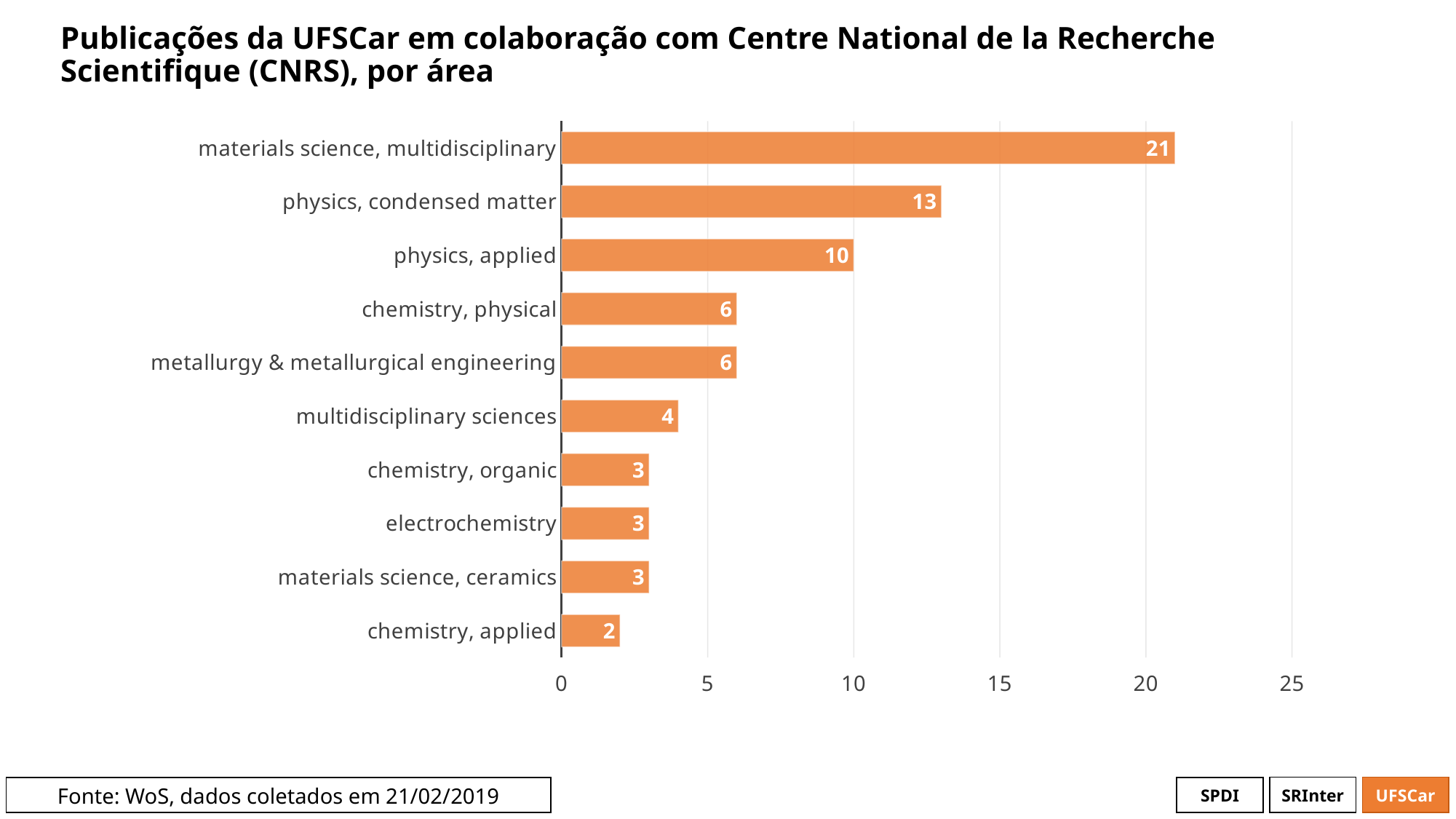
Which category has the lowest value? chemistry, applied What is the difference between the values for physics, applied and chemistry, physical? 4 How many categories are shown in the chart? 10 Which is larger, the value for physics, applied or the value for multidisciplinary sciences? physics, applied Which category has the highest value? materials science, multidisciplinary What is the value for physics, condensed matter? 13 What is the value for multidisciplinary sciences? 4 What is the value for materials science, multidisciplinary? 21 What is the value for chemistry, applied? 2 What kind of chart is shown on the slide? bar chart What is the difference between the values for materials science, multidisciplinary and physics, condensed matter? 8 What is the title of the chart? Publicações da UFSCar em colaboração com Centre National de la Recherche Scientifique (CNRS), por área